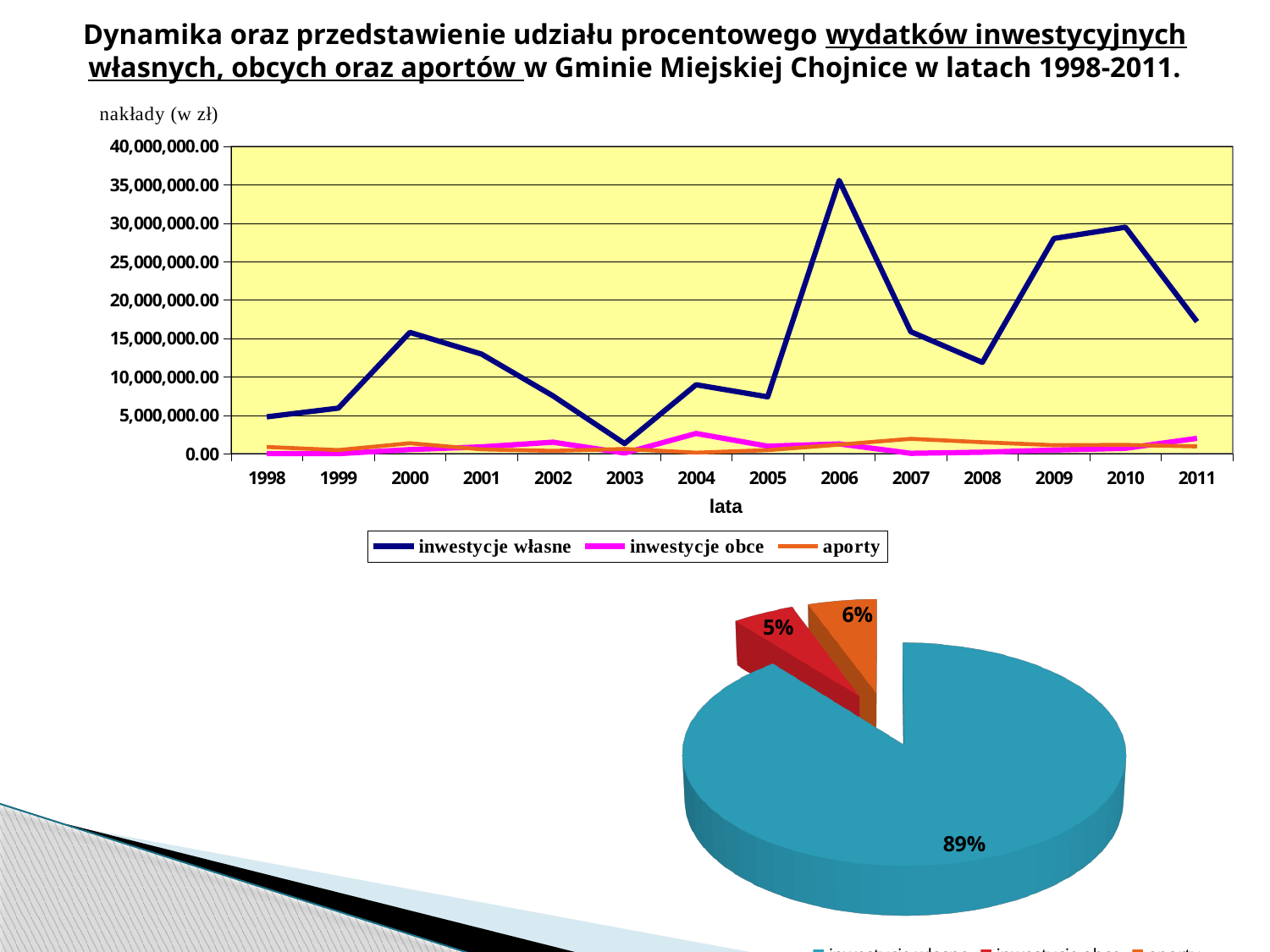
In the bottom pie chart, what share does the largest (blue) slice have? 89% In the top line chart, is the value for 'inwestycje własne' in 2006 greater or less than 30,000,000.00? greater In the top line chart, does the 'inwestycje własne' series rise or fall from 2000 to 2003? fall In the top line chart, is the value for 'inwestycje własne' in 2008 greater or less than 15,000,000.00? less In the top line chart, how many years are shown on the x axis? 14 In the top line chart, in which year is the 'inwestycje własne' series at its lowest value? 2003 What kind of chart is the bottom chart on the slide? pie chart In the top line chart, in which year does the 'inwestycje własne' series reach its highest value? 2006 What kind of chart is the top chart on the slide? line chart In the top line chart, is the value for 'inwestycje własne' in 2003 greater or less than 5,000,000.00? less In the top line chart, which series is plotted with the dark blue line? inwestycje własne In the top line chart, how many series does the legend list? 3